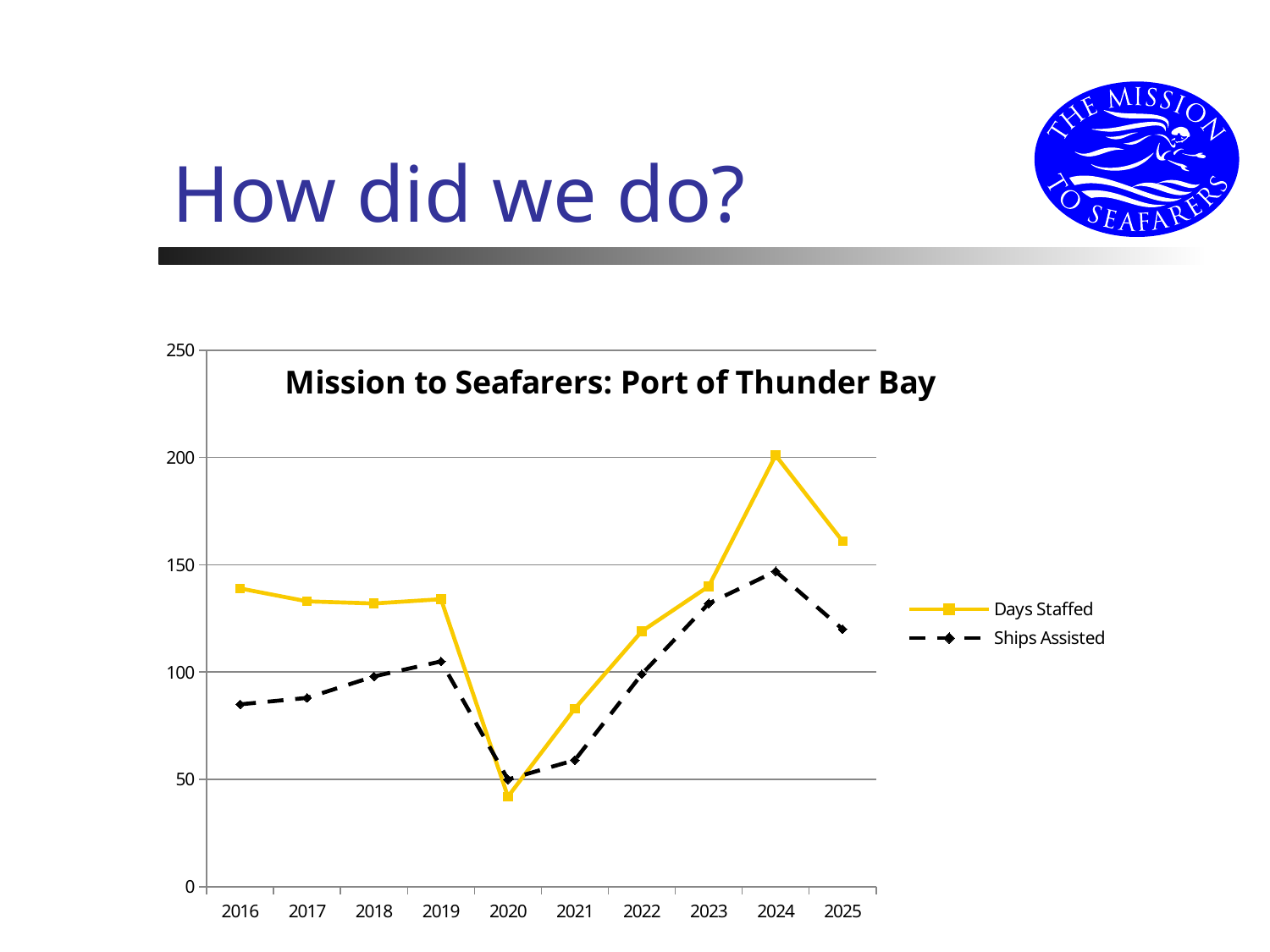
In which year is Days Staffed highest? 2024 What is the title of the chart? Mission to Seafarers: Port of Thunder Bay In which year is Ships Assisted highest? 2024 Is the value for Ships Assisted in 2016 greater or less than 100? less How many series does the legend list? 2 Do the Days Staffed values rise or fall from 2020 to 2024? rise In 2024, which is larger: Days Staffed or Ships Assisted? Days Staffed What kind of chart is shown on the slide? line chart Is the value for Days Staffed in 2024 greater or less than 150? greater How many years are plotted along the x axis? 10 Is the value for Days Staffed in 2020 greater or less than 50? less In which year is Days Staffed lowest? 2020